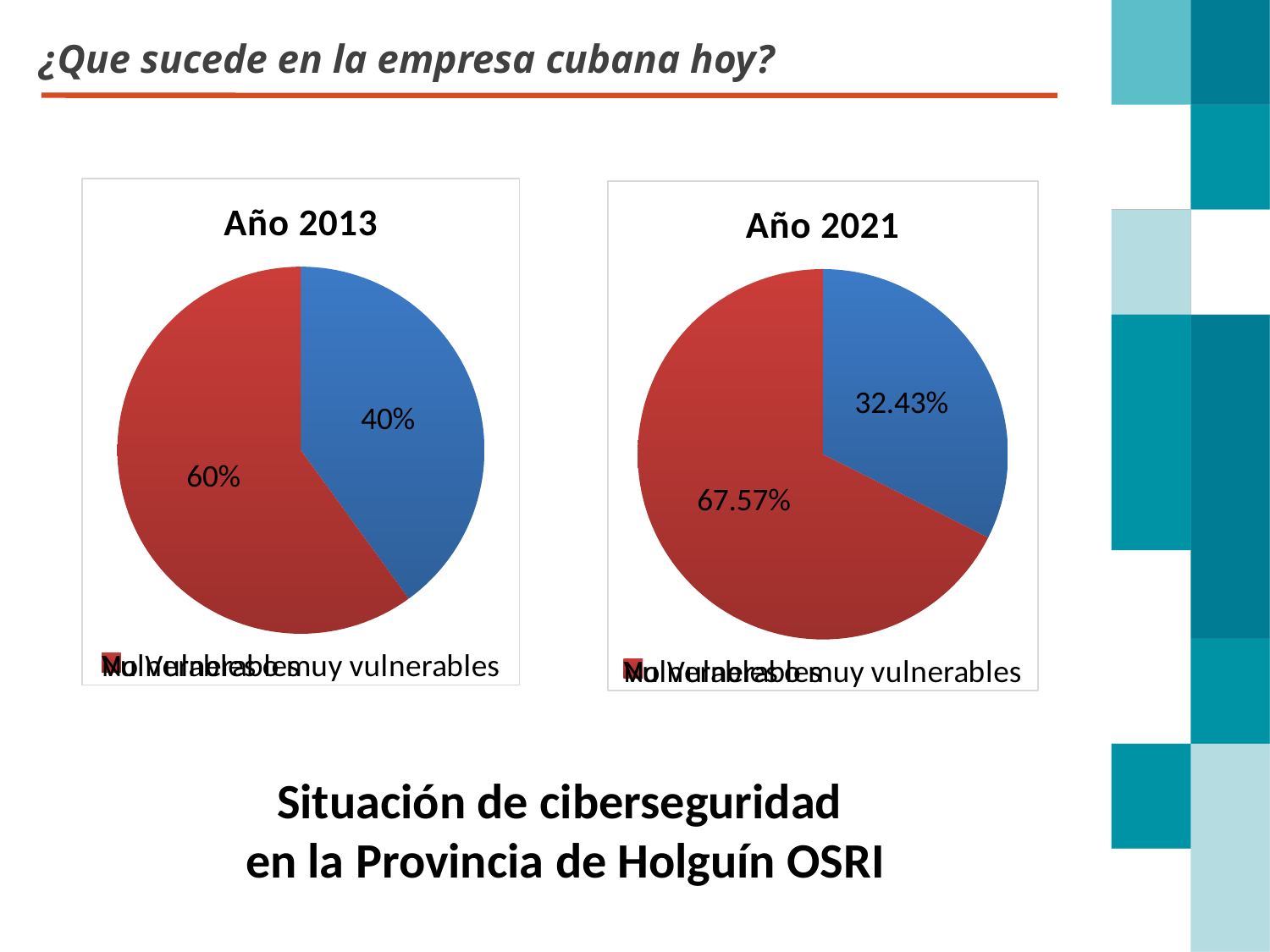
Is the red slice larger in the "Año 2013" chart or in the "Año 2021" chart? Año 2021 In the "Año 2021" pie chart, what percentage is shown on the red slice? 67.57% In the "Año 2013" pie chart, what is the difference in percentage points between the red slice and the blue slice? 20 percentage points In the "Año 2021" pie chart, what percentage is shown on the blue slice? 32.43% In the "Año 2021" pie chart, which slice is the smallest? The blue slice (32.43%) In the "Año 2021" pie chart, what is the difference in percentage points between the red slice and the blue slice? 35.14 percentage points In the "Año 2013" pie chart, which slice is the largest? The red slice (60%) How many slices does the "Año 2021" pie chart have? 2 In the "Año 2013" pie chart, what percentage is shown on the blue slice? 40% What is the title of the chart on the right side of the slide? Año 2021 In the "Año 2013" pie chart, what percentage is shown on the red slice? 60% What type of chart is used for "Año 2013"? Pie chart